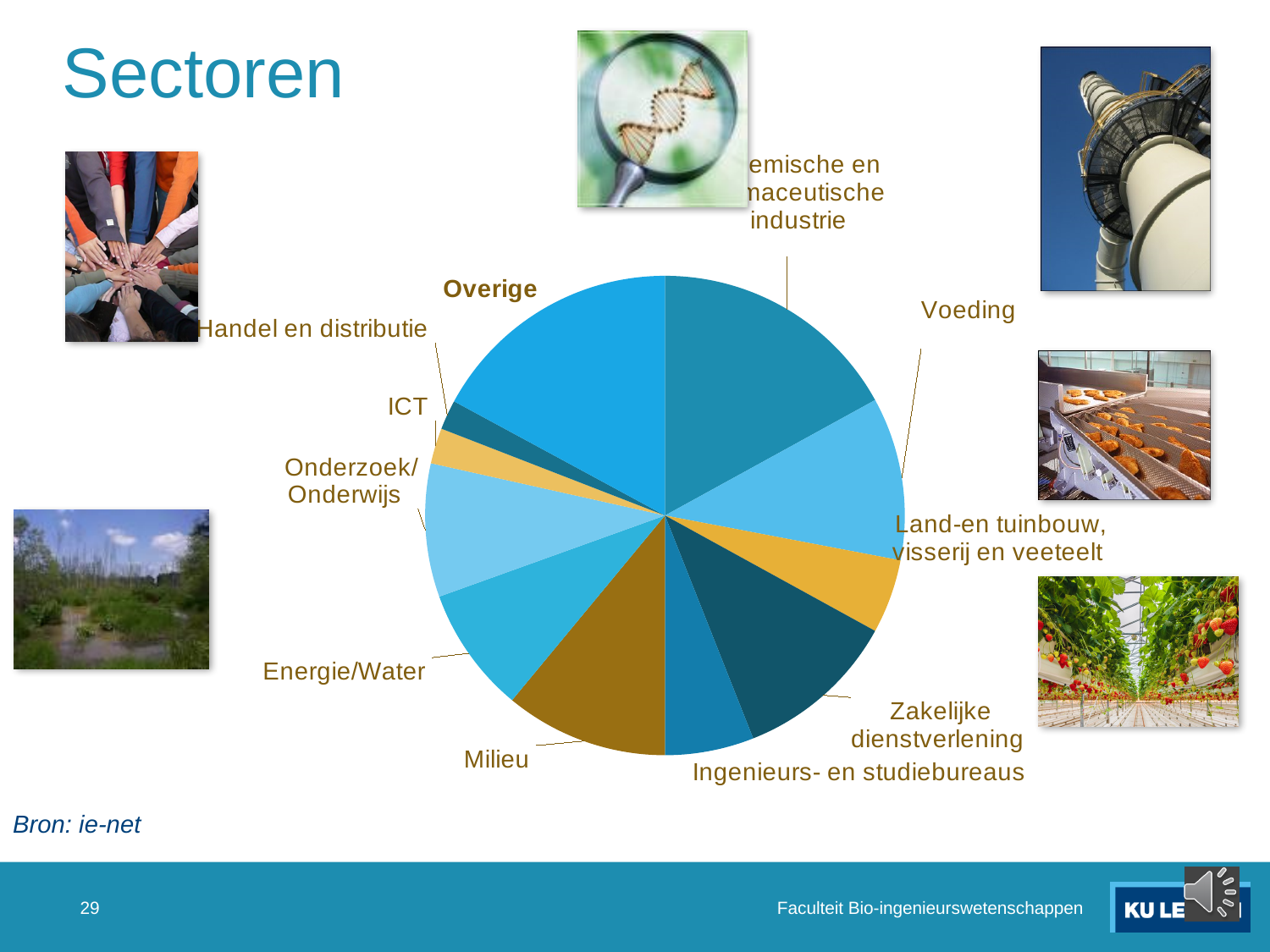
Which slice is larger, Overige or ICT? Overige Which slice is larger, Zakelijke dienstverlening or Ingenieurs- en studiebureaus? Zakelijke dienstverlening Which slice is larger, Milieu or ICT? Milieu What is the title of the slide containing the pie chart? Sectoren How many slices does the pie chart have? 11 Which slice label on the pie chart is printed in bold? Overige What kind of chart is shown on the slide? pie chart